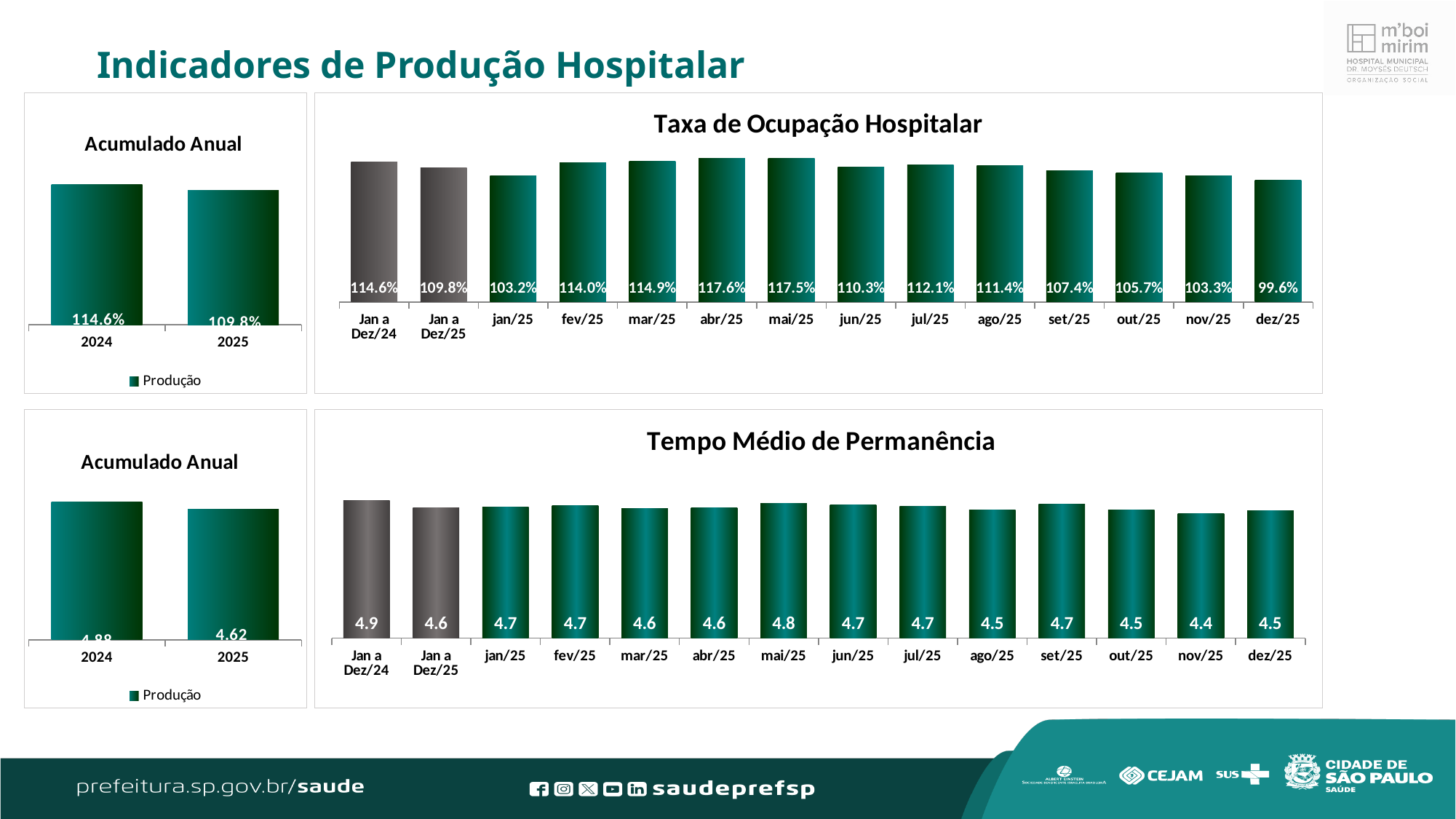
In the top-left 'Acumulado Anual' chart, what is the value for 2025? 109.8% What kind of chart is the 'Tempo Médio de Permanência' chart? Bar chart In the 'Taxa de Ocupação Hospitalar' chart, what is the value for abr/25? 117.6% In the 'Taxa de Ocupação Hospitalar' chart, which month of 2025 has the lowest value? dez/25 In the 'Taxa de Ocupação Hospitalar' chart, what is the difference between the values for Jan a Dez/24 and Jan a Dez/25? 4.8% In the 'Tempo Médio de Permanência' chart, which is larger, the value for Jan a Dez/24 or Jan a Dez/25? Jan a Dez/24 What series name does the legend of the top-left 'Acumulado Anual' chart show? Produção In the 'Taxa de Ocupação Hospitalar' chart, what is the value for dez/25? 99.6% In the bottom-left 'Acumulado Anual' chart, what is the difference between the values for 2024 and 2025? 0.26 In the 'Tempo Médio de Permanência' chart, which month of 2025 has the lowest value? nov/25 In the 'Taxa de Ocupação Hospitalar' chart, how many bars are plotted? 14 In the 'Tempo Médio de Permanência' chart, what is the value for mai/25? 4.8